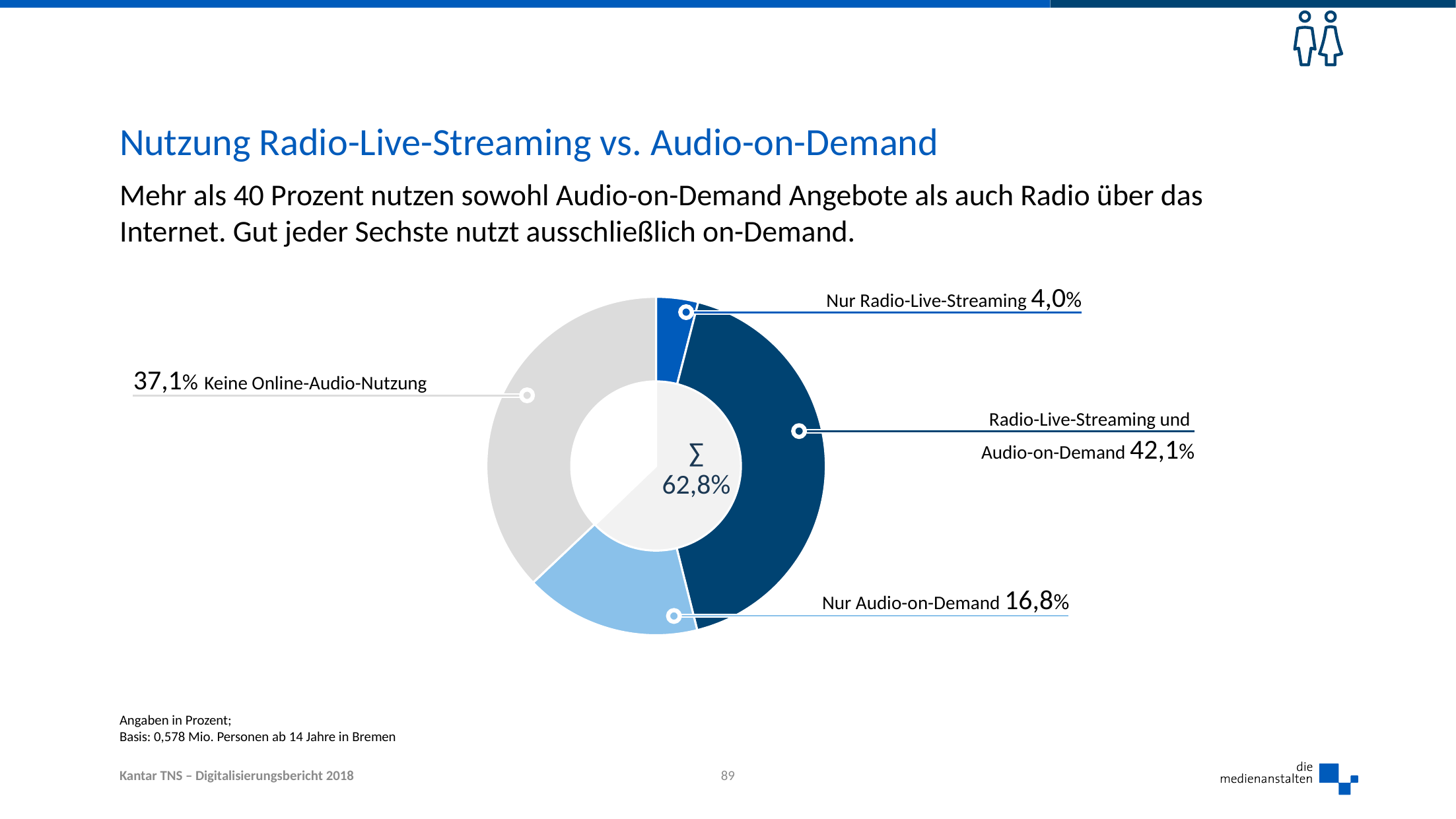
What kind of chart is shown on the slide? Pie chart (donut) What is the difference in percentage points between "Radio-Live-Streaming und Audio-on-Demand" and "Nur Audio-on-Demand"? 25,3 What percentage is shown for "Keine Online-Audio-Nutzung"? 37,1% What is the sum (∑) value shown in the centre of the chart? 62,8% What is the title of the slide? Nutzung Radio-Live-Streaming vs. Audio-on-Demand Which segment has the largest share? Radio-Live-Streaming und Audio-on-Demand How many segments does the chart have? 4 Which is larger: "Keine Online-Audio-Nutzung" or "Nur Audio-on-Demand"? Keine Online-Audio-Nutzung What percentage is shown for "Radio-Live-Streaming und Audio-on-Demand"? 42,1% What percentage is shown for "Nur Audio-on-Demand"? 16,8% What percentage is shown for "Nur Radio-Live-Streaming"? 4,0% Which segment has the smallest share? Nur Radio-Live-Streaming